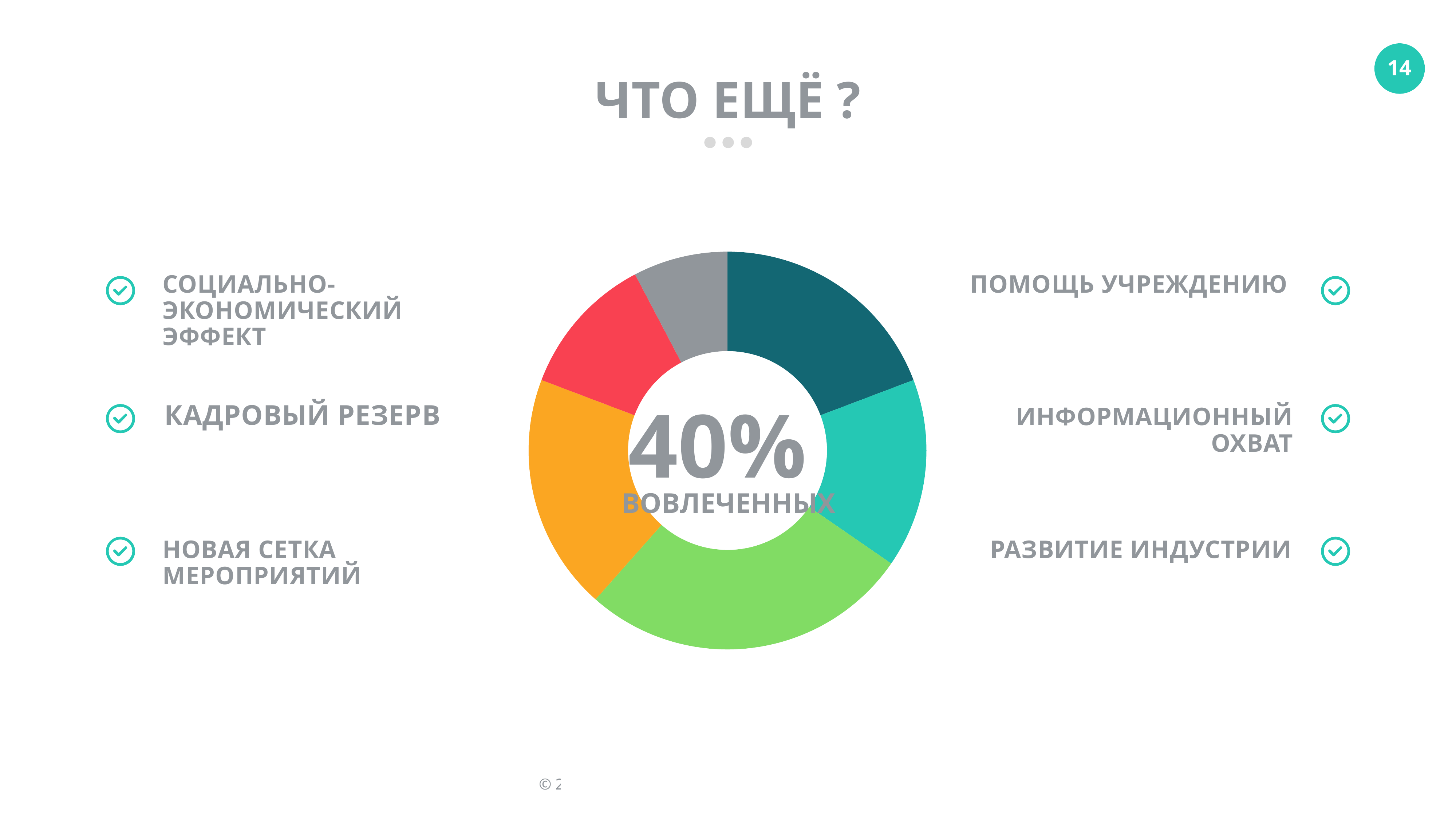
Does the donut chart have a legend? No Which slice is larger in the donut chart, the dark teal one or the grey one? Dark teal What kind of chart is shown on the slide? Donut (pie) chart What word is printed below the percentage in the centre of the donut chart? ВОВЛЕЧЕННЫХ Which colour slice is the largest in the donut chart? Green Which slice is larger in the donut chart, the green one or the orange one? Green How many slices does the donut chart have? 6 What percentage is printed in the centre of the donut chart? 40% Which slice is larger in the donut chart, the orange one or the grey one? Orange Which colour slice is the smallest in the donut chart? Grey